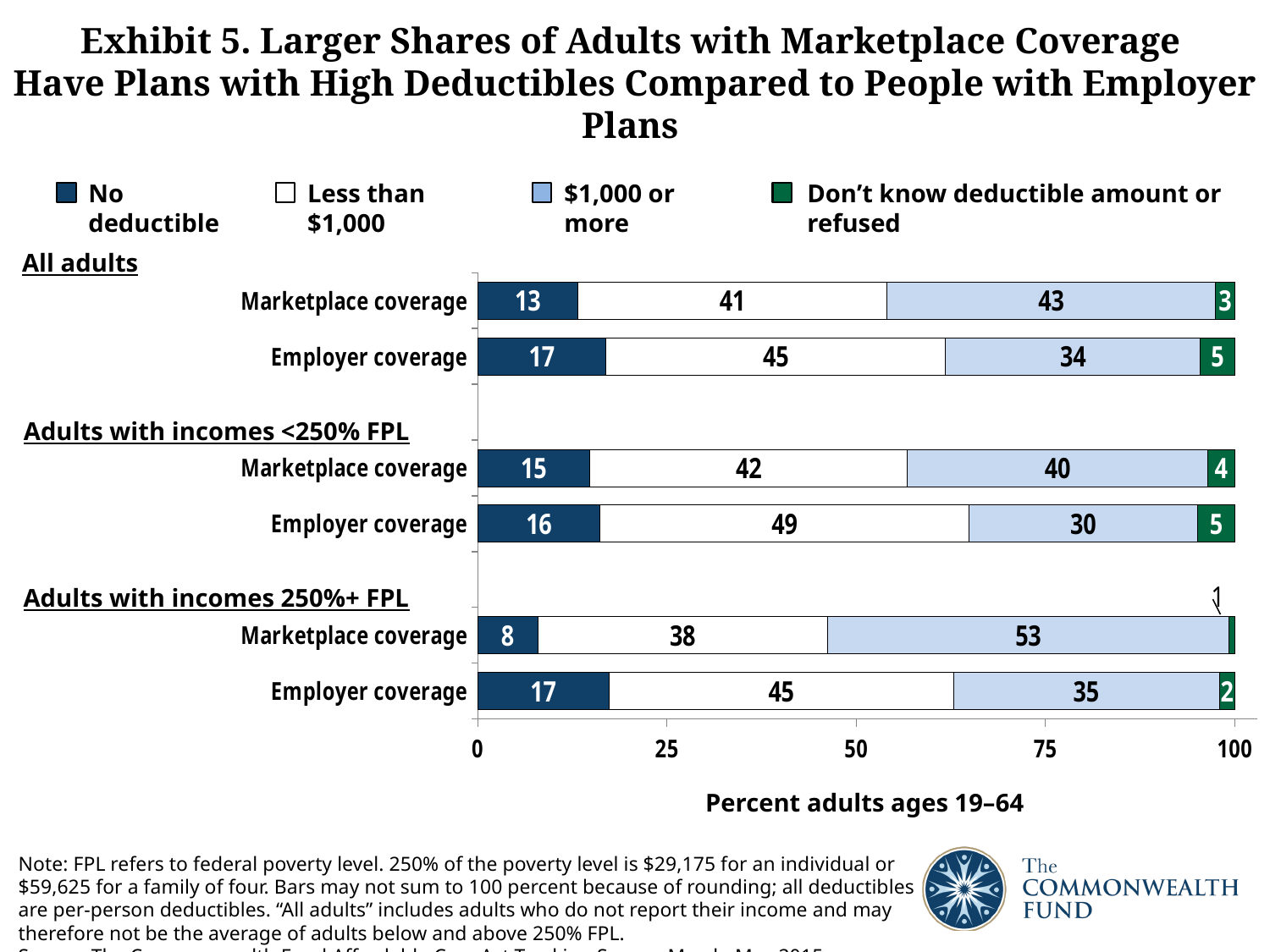
What is the total of the segments in the 'Marketplace coverage' bar for all adults? 100 What percentage of all adults with Marketplace coverage have a deductible of $1,000 or more? 43 Which bar has the lowest value for the 'No deductible' segment? Marketplace coverage, adults with incomes 250%+ FPL Among adults with incomes 250%+ FPL, what percentage of those with Employer coverage don't know their deductible amount or refused? 2 How many series does the legend list? 4 Among adults with incomes <250% FPL, what percentage of those with Employer coverage have a deductible of less than $1,000? 49 What kind of chart is shown on the slide? Stacked bar chart What is the label on the horizontal axis of the chart? Percent adults ages 19–64 Among adults with incomes <250% FPL, which has the larger 'Less than $1,000' value: Marketplace coverage or Employer coverage? Employer coverage Which bar has the highest value for the '$1,000 or more' segment? Marketplace coverage, adults with incomes 250%+ FPL How many bars are plotted in the chart? 6 For all adults, what is the difference between the '$1,000 or more' values for Marketplace coverage and Employer coverage? 9